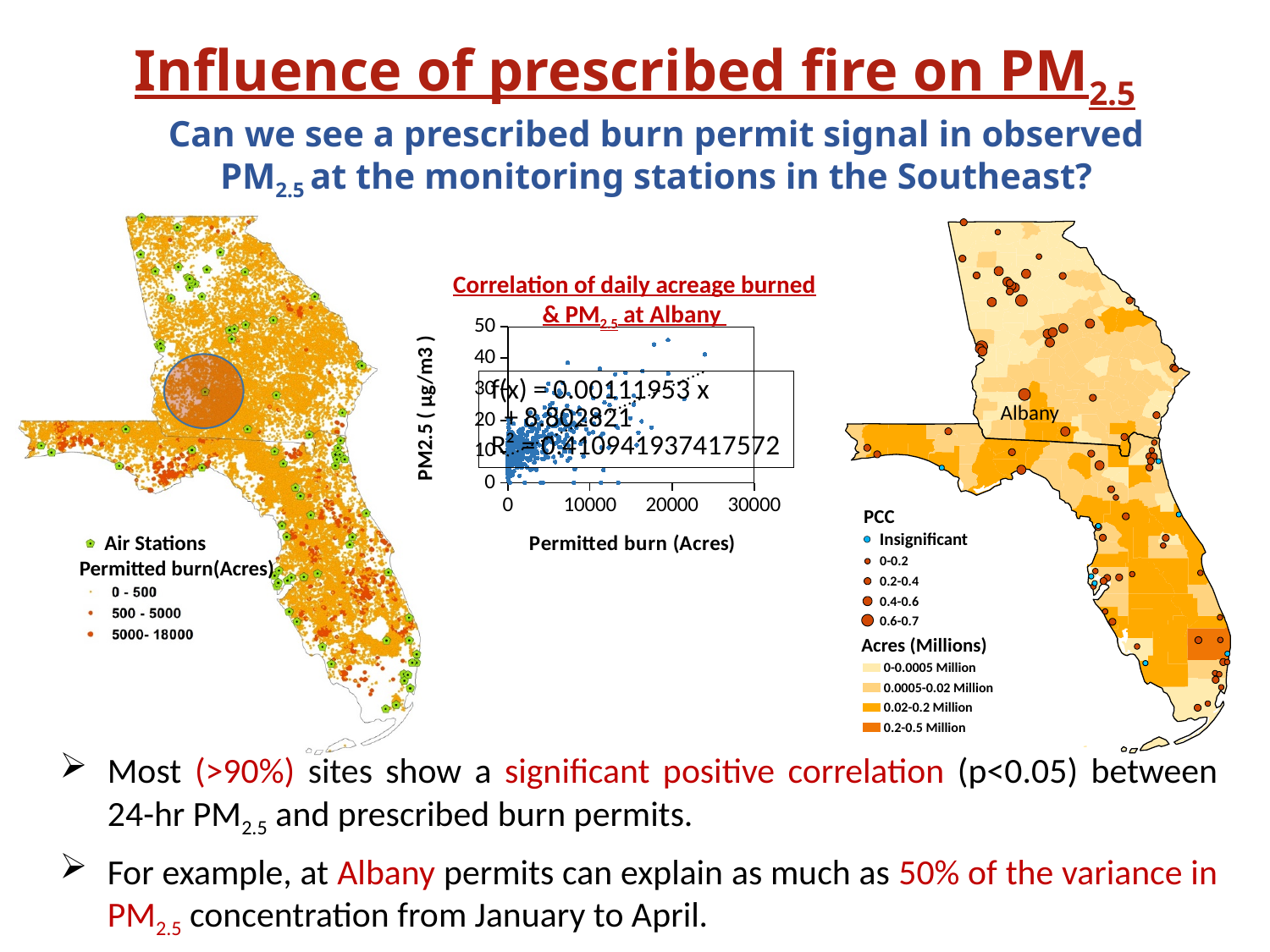
What kind of chart is the 'Correlation of daily acreage burned & PM2.5 at Albany' chart? scatter chart Is the R² value printed on the scatter chart greater or less than 0.5? less What is the highest tick value on the y axis of the scatter chart? 50 In the scatter chart, do PM2.5 values tend to rise or fall as permitted burn acreage increases? rise What R² value is printed on the scatter chart? 0.410941937417572 Is the trendline intercept printed on the scatter chart greater or less than 10? less What is the intercept of the trendline equation shown on the scatter chart? 8.802821 What is the highest tick value on the x axis of the scatter chart? 30000 In the scatter chart, what is the title of the y axis? PM2.5 ( µg/m3 ) In the scatter chart, what is the title of the x axis? Permitted burn (Acres) What is the slope of the trendline equation shown on the scatter chart? 0.00111953